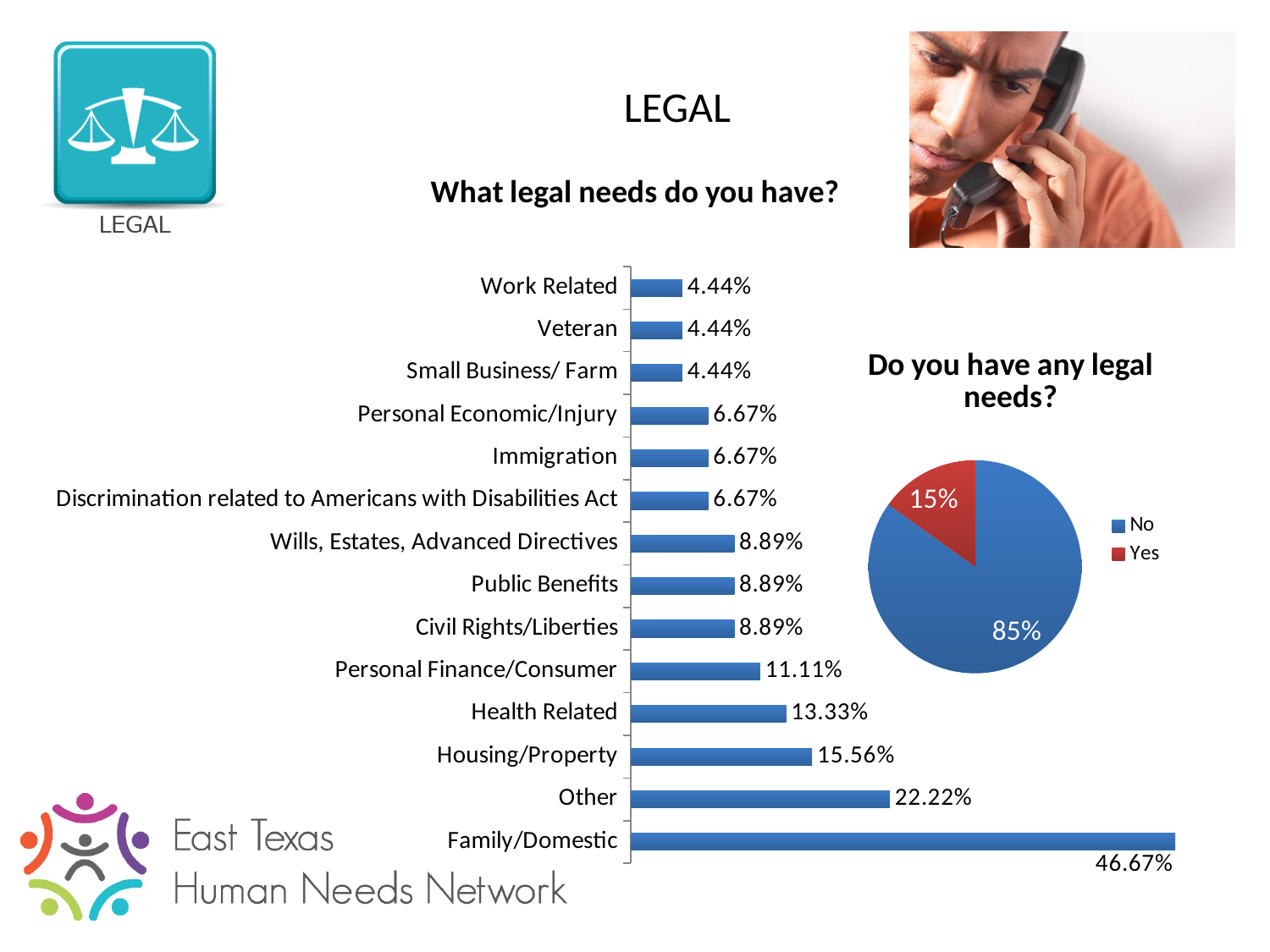
How many categories are shown in the 'What legal needs do you have?' chart? 14 In the 'Do you have any legal needs?' chart, what colour is the Yes slice? Red What kind of chart is 'What legal needs do you have?' Bar chart How many series does the legend of the 'Do you have any legal needs?' chart list? 2 In the 'What legal needs do you have?' chart, which is larger: Health Related or Civil Rights/Liberties? Health Related In the 'What legal needs do you have?' chart, what is the value for Personal Finance/Consumer? 11.11% In the 'What legal needs do you have?' chart, what is the value for Housing/Property? 15.56% What kind of chart is 'Do you have any legal needs?' Pie chart In the 'Do you have any legal needs?' chart, what share of respondents answered Yes? 15% In the 'What legal needs do you have?' chart, which category has the highest value? Family/Domestic In the 'What legal needs do you have?' chart, what is the difference between Family/Domestic and Other? 24.45% In the 'Do you have any legal needs?' chart, what share of respondents answered No? 85%